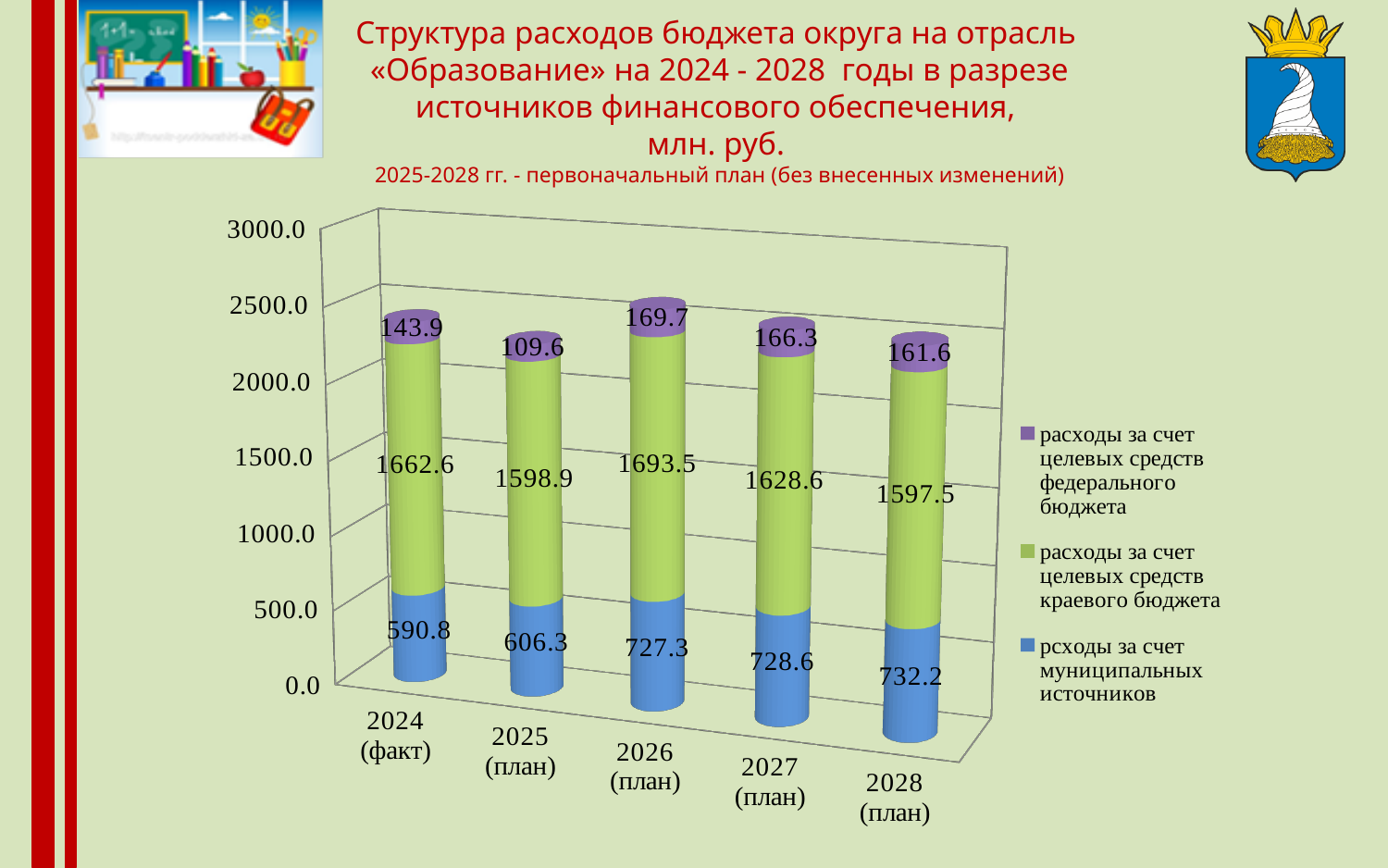
What type of chart is shown on the slide? stacked bar chart How many year categories are shown along the x axis? 5 What is the value of расходы за счет муниципальных источников for 2024 (факт)? 590.8 In which year is the value of расходы за счет целевых средств федерального бюджета the highest? 2026 (план) What is the total of the stacked bar for 2024 (факт)? 2397.3 Which is larger: расходы за счет целевых средств краевого бюджета in 2027 (план) or in 2028 (план)? 2027 (план) How many series does the legend list? 3 In which year is the value of расходы за счет муниципальных источников the lowest? 2024 (факт) What is the value of расходы за счет целевых средств краевого бюджета for 2026 (план)? 1693.5 What is the difference between расходы за счет муниципальных источников in 2028 (план) and 2024 (факт)? 141.4 What is the value of расходы за счет целевых средств федерального бюджета for 2025 (план)? 109.6 Does the value of расходы за счет муниципальных источников rise or fall from 2024 (факт) to 2028 (план)? rise